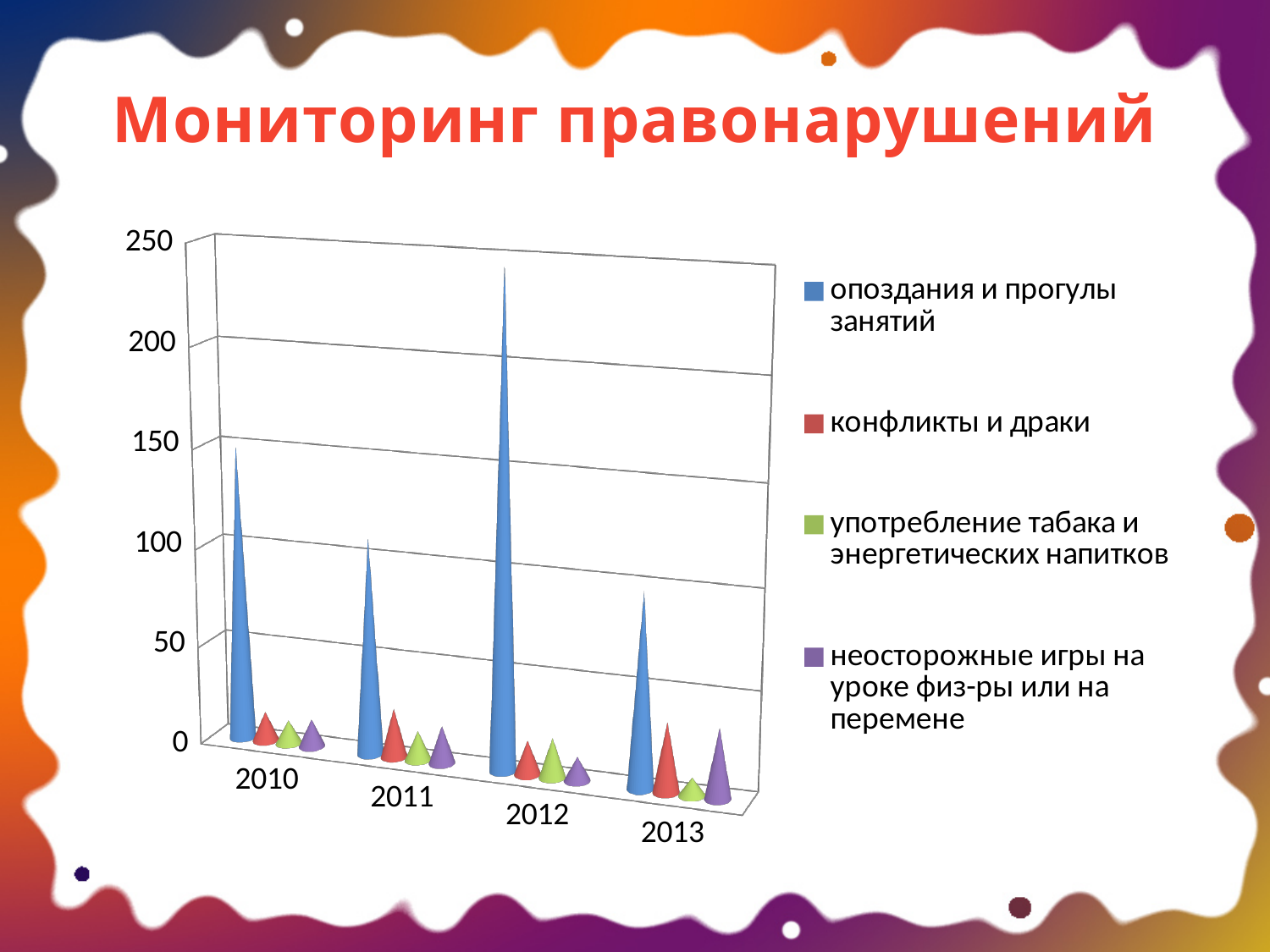
In which year is the value for 'опоздания и прогулы занятий' the highest? 2012 Which is larger: the value for 'опоздания и прогулы занятий' in 2010 or in 2011? 2010 How many series does the legend list? 4 Is the value for 'опоздания и прогулы занятий' in 2012 greater or less than 200? greater What is the title of the chart on the slide? Мониторинг правонарушений In which year is the value for 'опоздания и прогулы занятий' the lowest? 2013 Which series has the lowest value in 2013? употребление табака и энергетических напитков Is the value for 'опоздания и прогулы занятий' in 2011 greater or less than 150? less How many years are shown on the x axis of the chart? 4 Is the value for 'опоздания и прогулы занятий' in 2010 greater or less than 100? greater What kind of chart is shown on the slide? bar chart Which colour represents the series 'конфликты и драки' in the legend? red